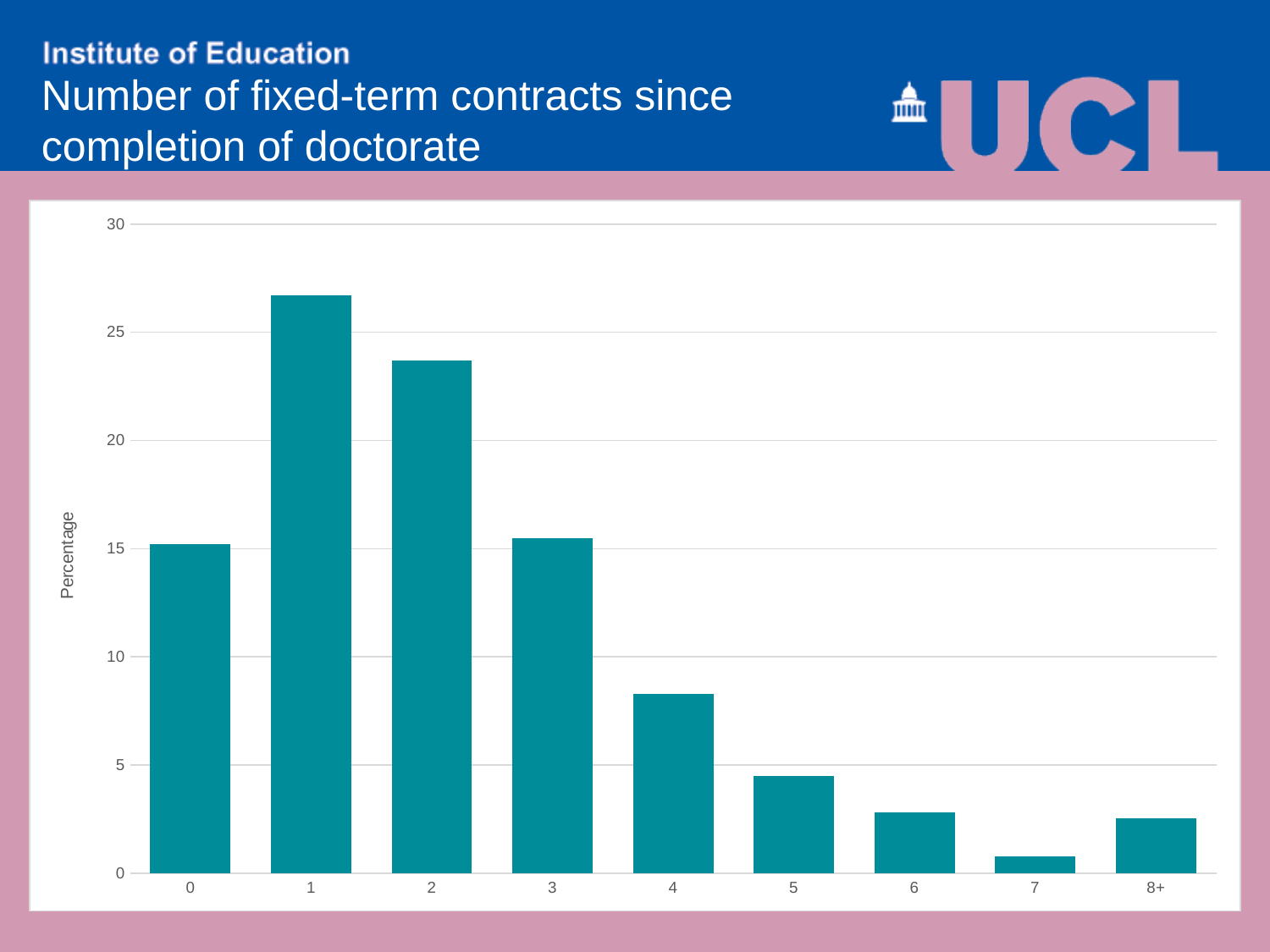
Is the value for category 4 greater or less than 10? less How many categories are shown on the x axis of the chart? 9 Is the value for category 1 greater or less than 25? greater What is the label on the y axis of the chart? Percentage Is the value for category 2 greater or less than 25? less Which category has the lowest percentage? 7 What kind of chart is shown on the slide? bar chart Which category has the highest percentage? 1 Do the values rise or fall from category 1 to category 7? fall Which has the larger percentage, category 1 or category 2? 1